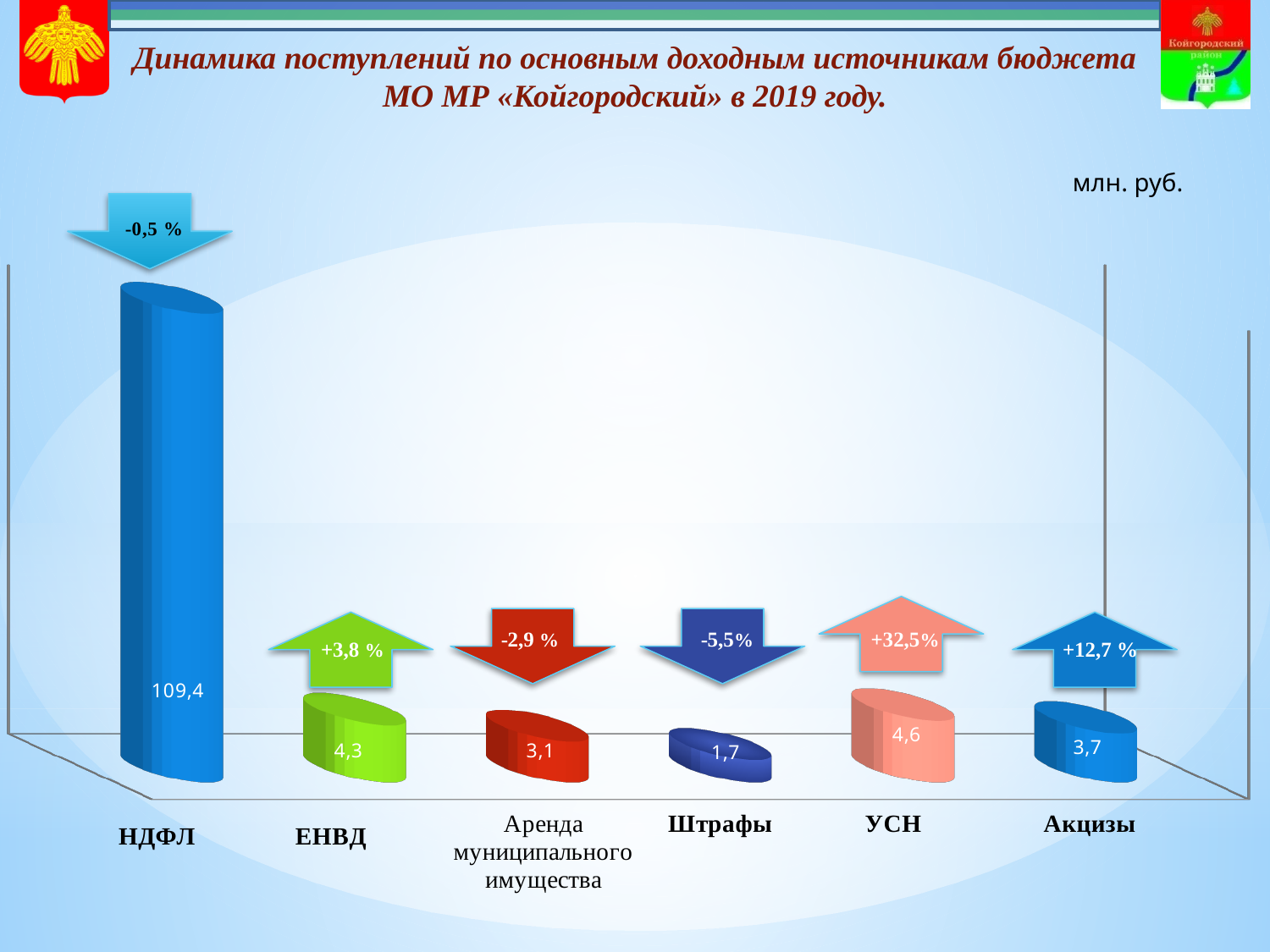
What is the value for УСН? 4,6 What is the difference between the values for УСН and ЕНВД? 0,3 Which is larger, the value for Аренда муниципального имущества or the value for Акцизы? Акцизы What is the difference between the values for Акцизы and Штрафы? 2,0 What is the value for НДФЛ? 109,4 What is the value for Штрафы? 1,7 Which category has the highest value? НДФЛ What is the value for ЕНВД? 4,3 What kind of chart is shown on the slide? bar chart What percentage change is shown on the arrow above УСН? +32,5% How many categories are shown in the chart? 6 Which category has the lowest value? Штрафы